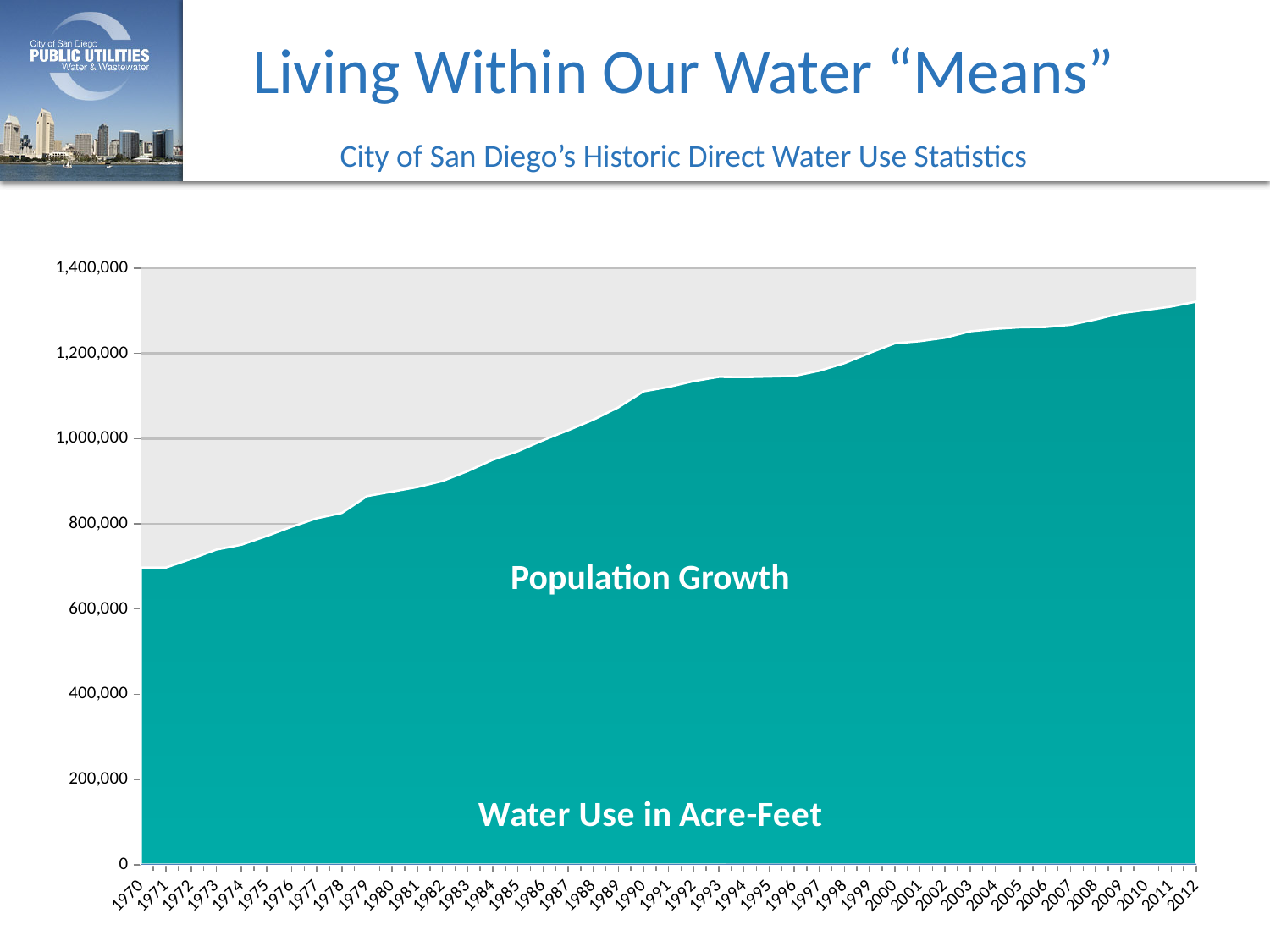
How many years are plotted along the x axis? 43 Which is larger, the value for 2000 or the value for 1980? 2000 Which year has the highest value on the chart? 2012 Is the value for 1990 greater or less than 1,000,000? greater Is the value for 1980 greater or less than 800,000? greater Is the value for 1970 greater or less than 800,000? less What is the highest value shown on the y axis? 1,400,000 Do the values rise or fall from 1970 to 2012? Rise What kind of chart is shown on the slide? Area chart